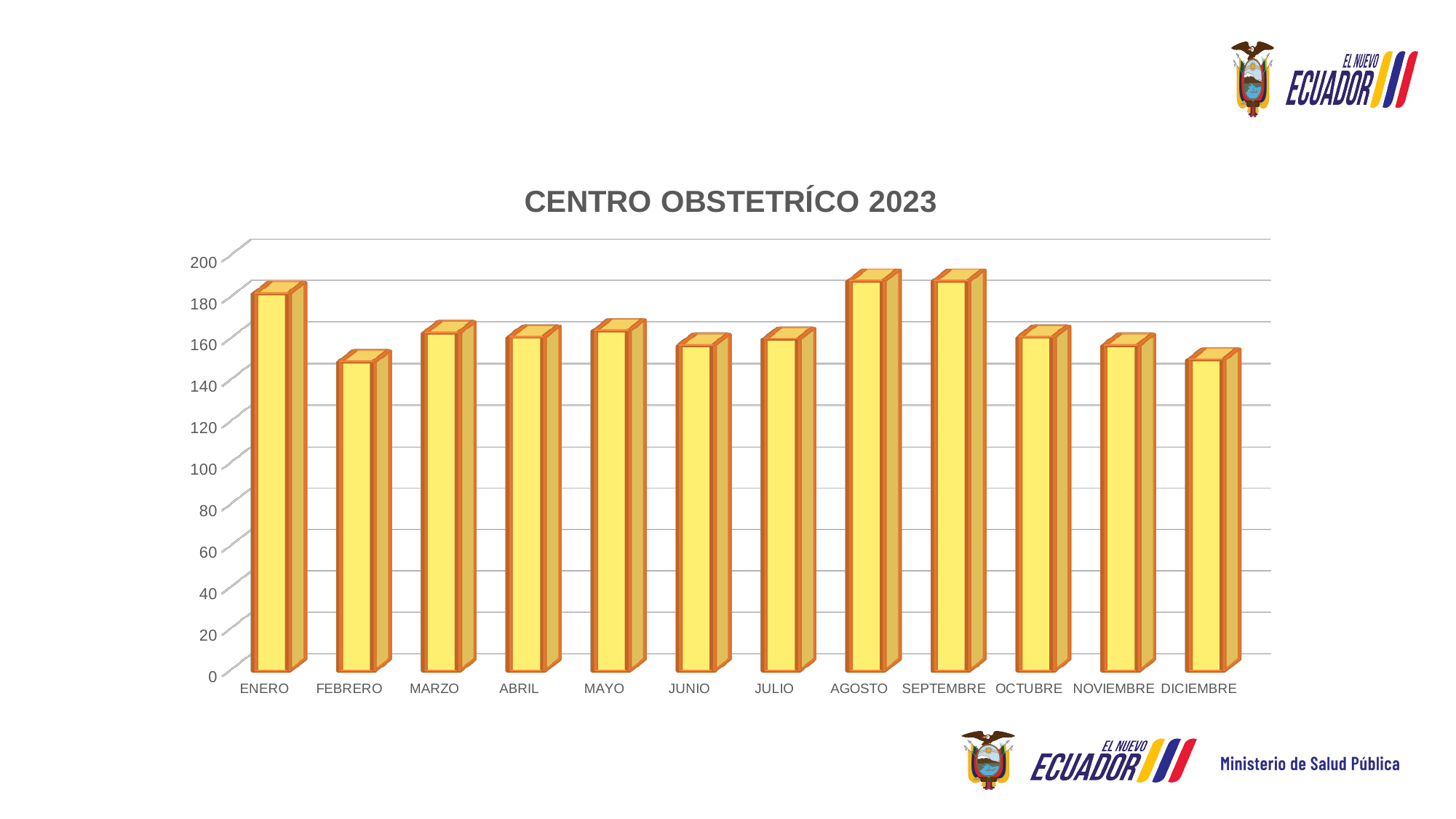
What is the title of the chart? CENTRO OBSTETRÍCO 2023 What kind of chart is shown on the slide? bar chart Is the value for FEBRERO greater or less than 160? less Is the value for DICIEMBRE greater or less than 160? less Is the value for JUNIO greater or less than 180? less How many months (categories) are plotted on the x axis? 12 Which is larger, the value for SEPTEMBRE or the value for OCTUBRE? SEPTEMBRE Which is larger, the value for ENERO or the value for FEBRERO? ENERO Which is larger, the value for DICIEMBRE or the value for AGOSTO? AGOSTO